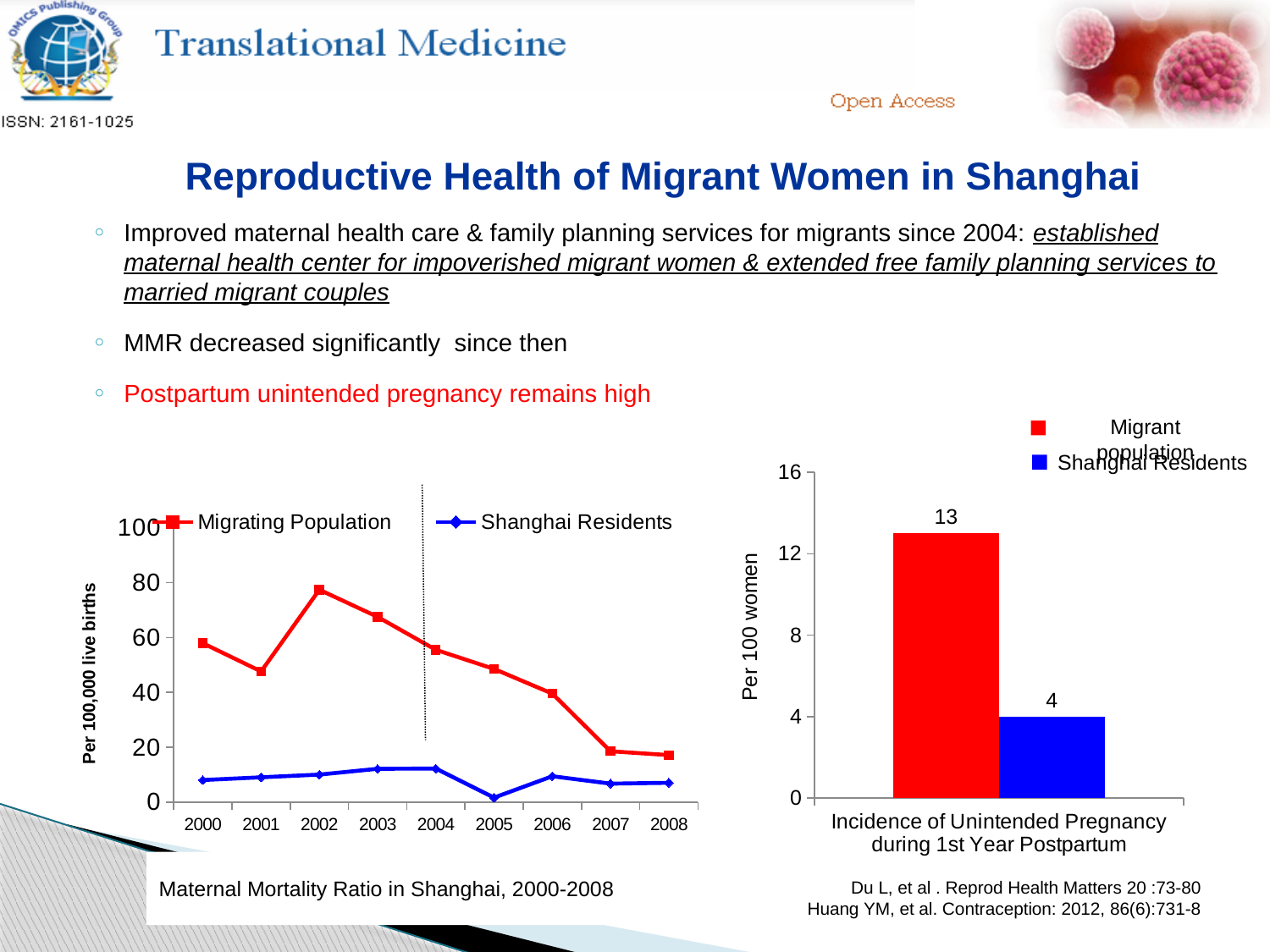
What kind of chart is the Maternal Mortality Ratio in Shanghai, 2000-2008 chart? Line chart In the Maternal Mortality Ratio in Shanghai, 2000-2008 chart, is the Migrating Population value for 2007 greater or less than 40? less In the bar chart on the right, which group has the higher incidence of unintended pregnancy: Migrant population or Shanghai Residents? Migrant population In the Maternal Mortality Ratio in Shanghai, 2000-2008 chart, does the Migrating Population series rise or fall between 2004 and 2008? fall In the bar chart on the right, what is the difference between the Migrant population value and the Shanghai Residents value? 9 What kind of chart is the chart on the right of the slide? Bar chart How many years are shown on the x axis of the Maternal Mortality Ratio in Shanghai, 2000-2008 chart? 9 In the bar chart on the right, what is the value for Migrant population? 13 In the bar chart on the right, what is the unit shown on the vertical axis? Per 100 women In the Maternal Mortality Ratio in Shanghai, 2000-2008 chart, is the Migrating Population value for 2002 greater or less than 60? greater How many series does the legend of the Maternal Mortality Ratio in Shanghai, 2000-2008 chart list? 2 In the bar chart on the right, what is the value for Shanghai Residents? 4